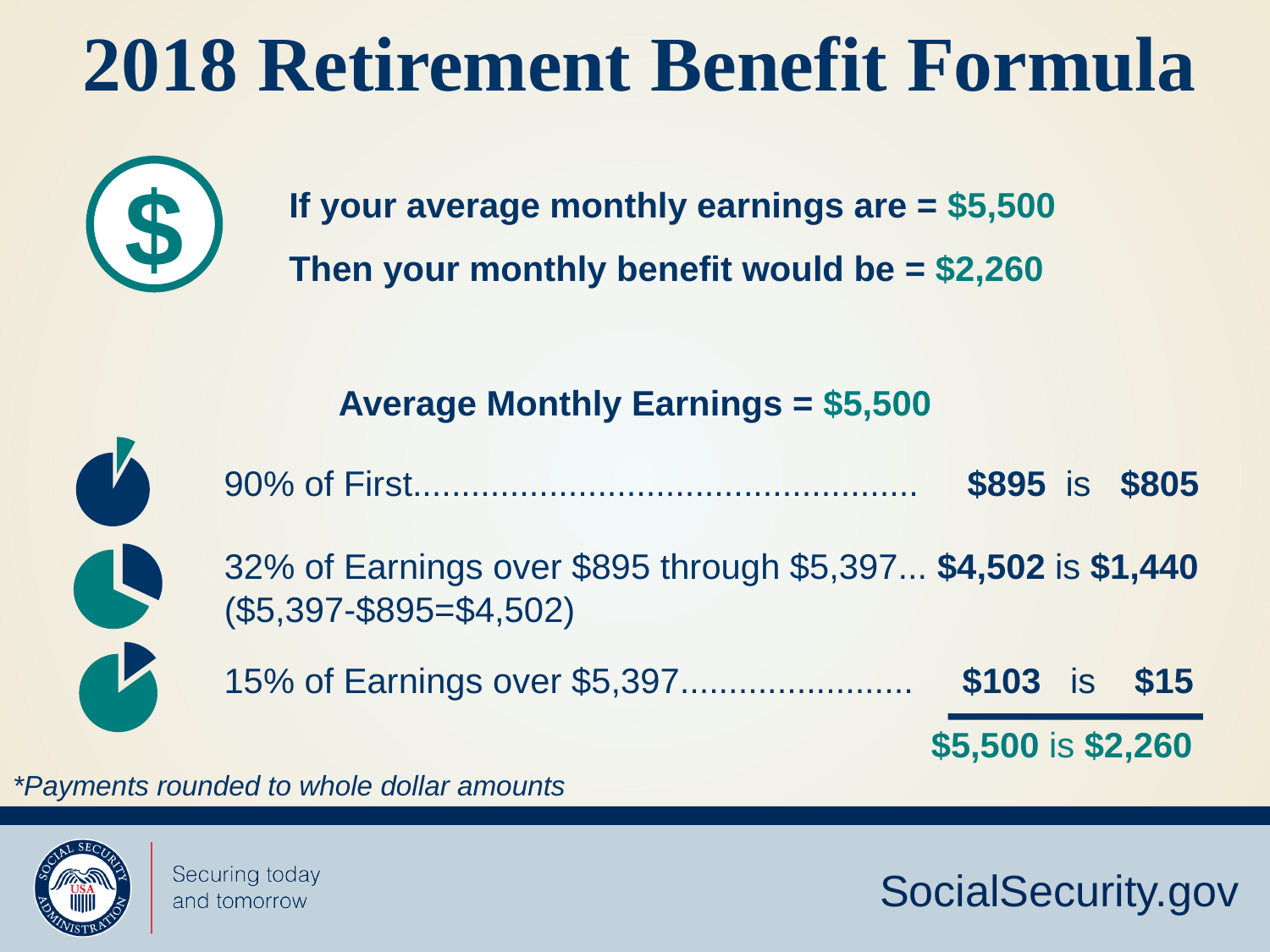
What is the benefit amount from the 90% tier (90% of the first $895)? $805 What is the benefit amount from the 32% tier (32% of $4,502)? $1,440 Which tier contributes the smallest benefit amount? 15% tier ($15) What percentage does the middle pie chart (second tier) represent? 32% What percentage does the top pie chart (first tier) represent? 90% Which tier contributes the largest benefit amount? 32% tier ($1,440) What percentage does the bottom pie chart (third tier) represent? 15% What is the benefit amount from the 15% tier (15% of $103)? $15 What is the difference between the 32% tier benefit ($1,440) and the 90% tier benefit ($805)? $635 What kind of chart icons are shown beside the three benefit formula tiers? Pie charts How many pie chart icons are shown on the slide? 3 What is the total monthly benefit for average monthly earnings of $5,500? $2,260